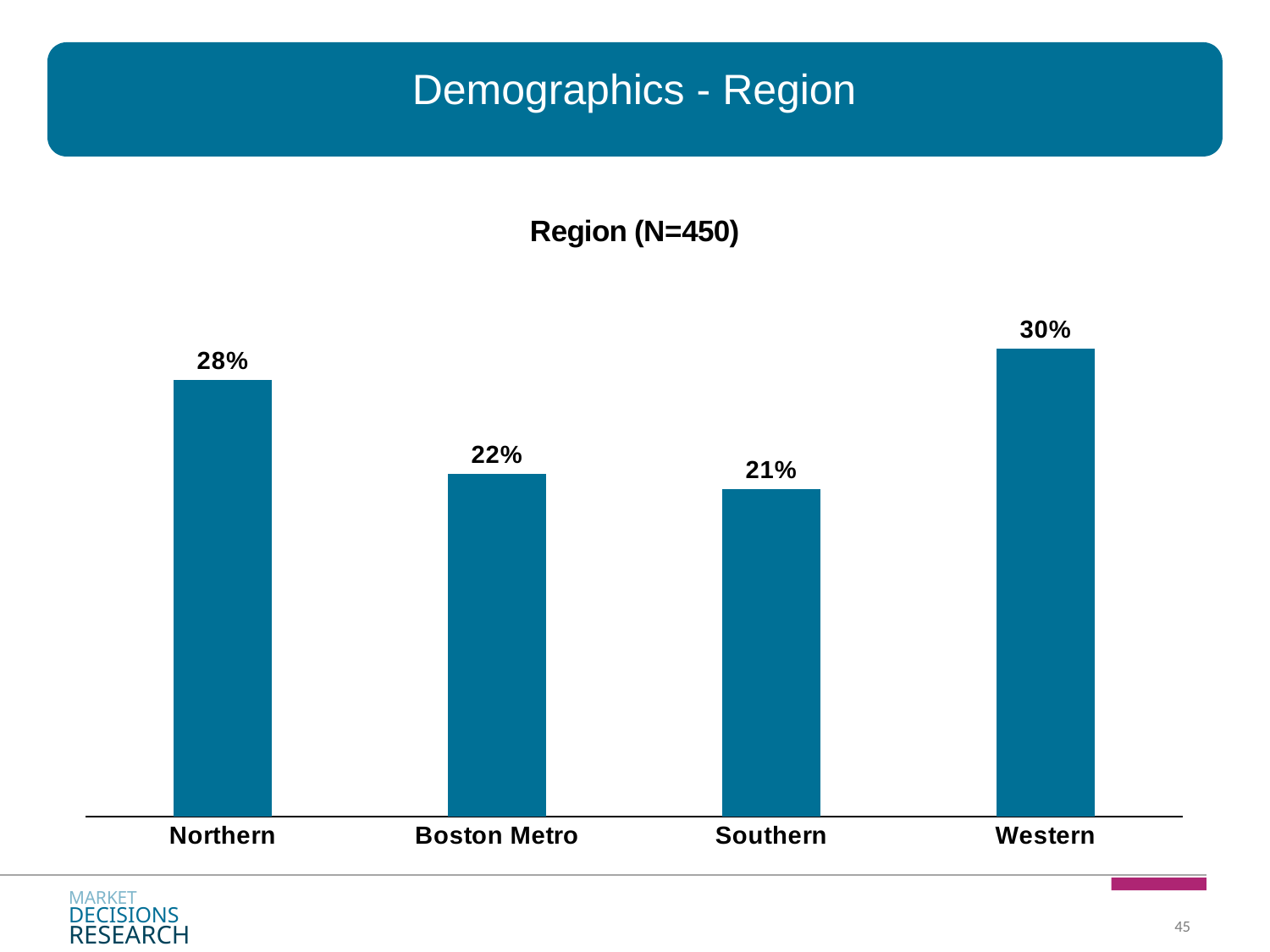
What is the value for Southern? 21% What is the title of the chart? Region (N=450) What is the difference between the values for Northern and Southern? 7% What is the value for Northern? 28% What is the value for Western? 30% What is the value for Boston Metro? 22% Which is larger, the value for Northern or the value for Boston Metro? Northern What kind of chart is shown on the slide? Bar chart Which region has the lowest value? Southern What is the difference between the values for Western and Northern? 2% How many regions are shown in the chart? 4 Which region has the highest value? Western